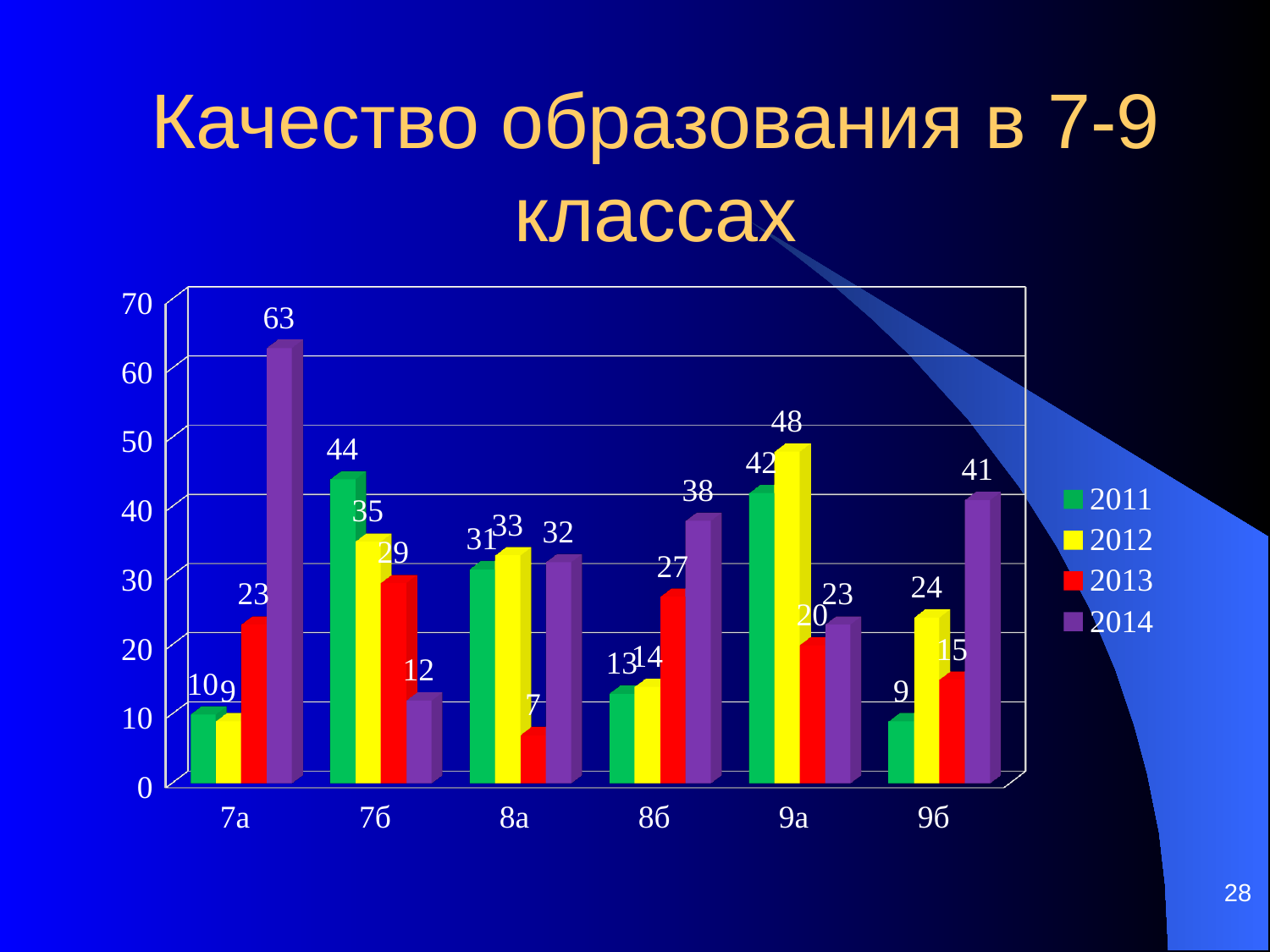
Which class has the highest value in the 2014 series? 7а What is the value for 7а in the 2014 series? 63 How many series does the legend list? 4 How many classes are shown on the x axis? 6 Which is larger for 7б: the 2011 value or the 2014 value? 2011 What is the title of the slide? Качество образования в 7-9 классах What kind of chart is shown on the slide? bar chart What is the value for 8а in the 2013 series? 7 What is the value for 9а in the 2012 series? 48 What is the difference between the 2014 and 2011 values for 7а? 53 Which class has the lowest value in the 2013 series? 8а What is the value for 9б in the 2011 series? 9